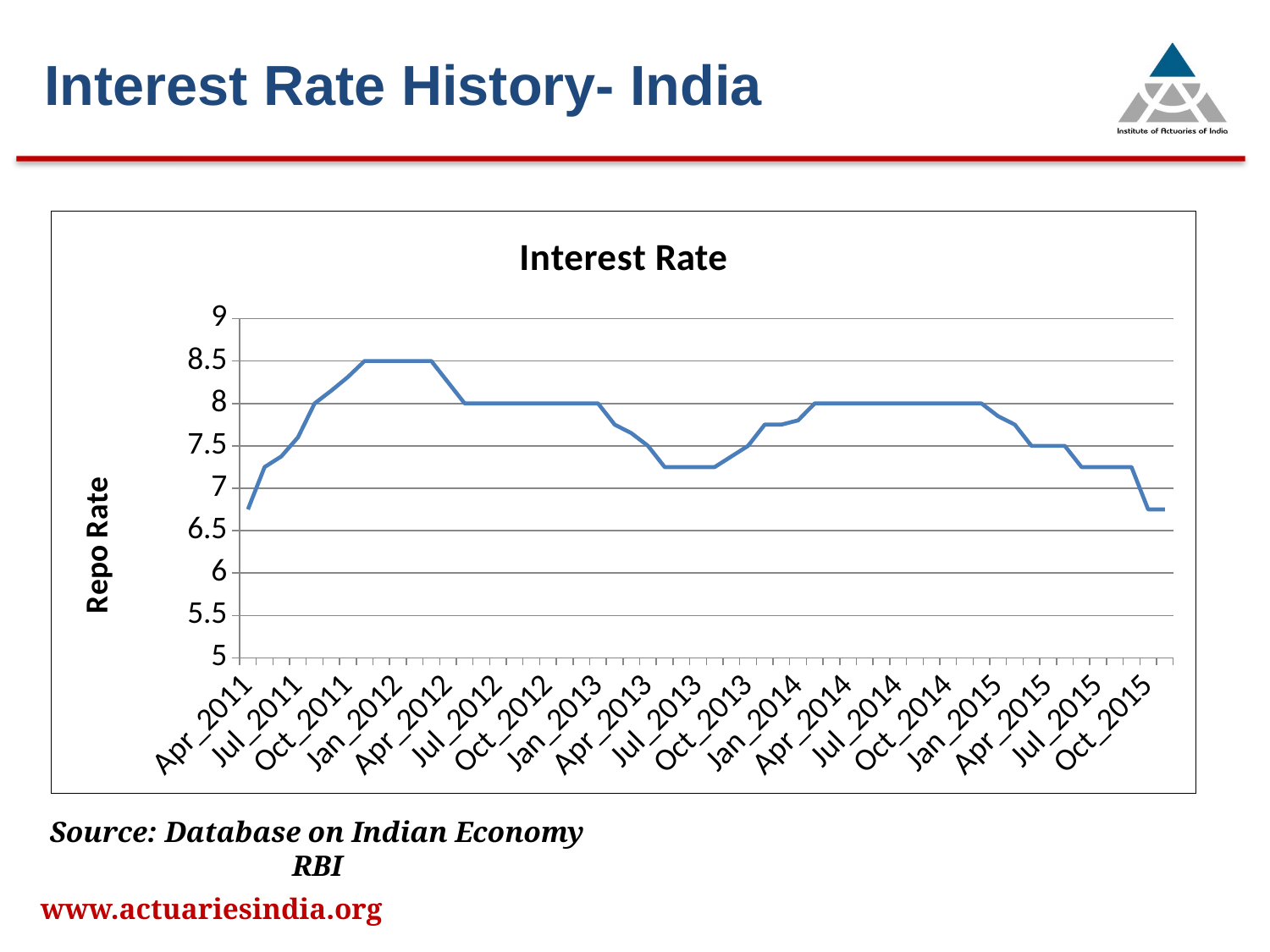
What is the repo rate at Jan_2012? 8.5 What kind of chart is shown on the slide? line chart What is the highest repo rate reached on the chart? 8.5 Is the repo rate at Apr_2011 greater or less than 7? less What is the repo rate at Apr_2015? 7.5 Does the repo rate rise or fall between Jan_2015 and Oct_2015? fall What is the repo rate at Jul_2014? 8 What is the repo rate at Oct_2012? 8 What is the title of the chart? Interest Rate Is the repo rate at Jul_2013 greater or less than 7.5? less What is the label on the vertical axis of the chart? Repo Rate Which is higher, the repo rate at Jan_2012 or at Jan_2014? Jan_2012